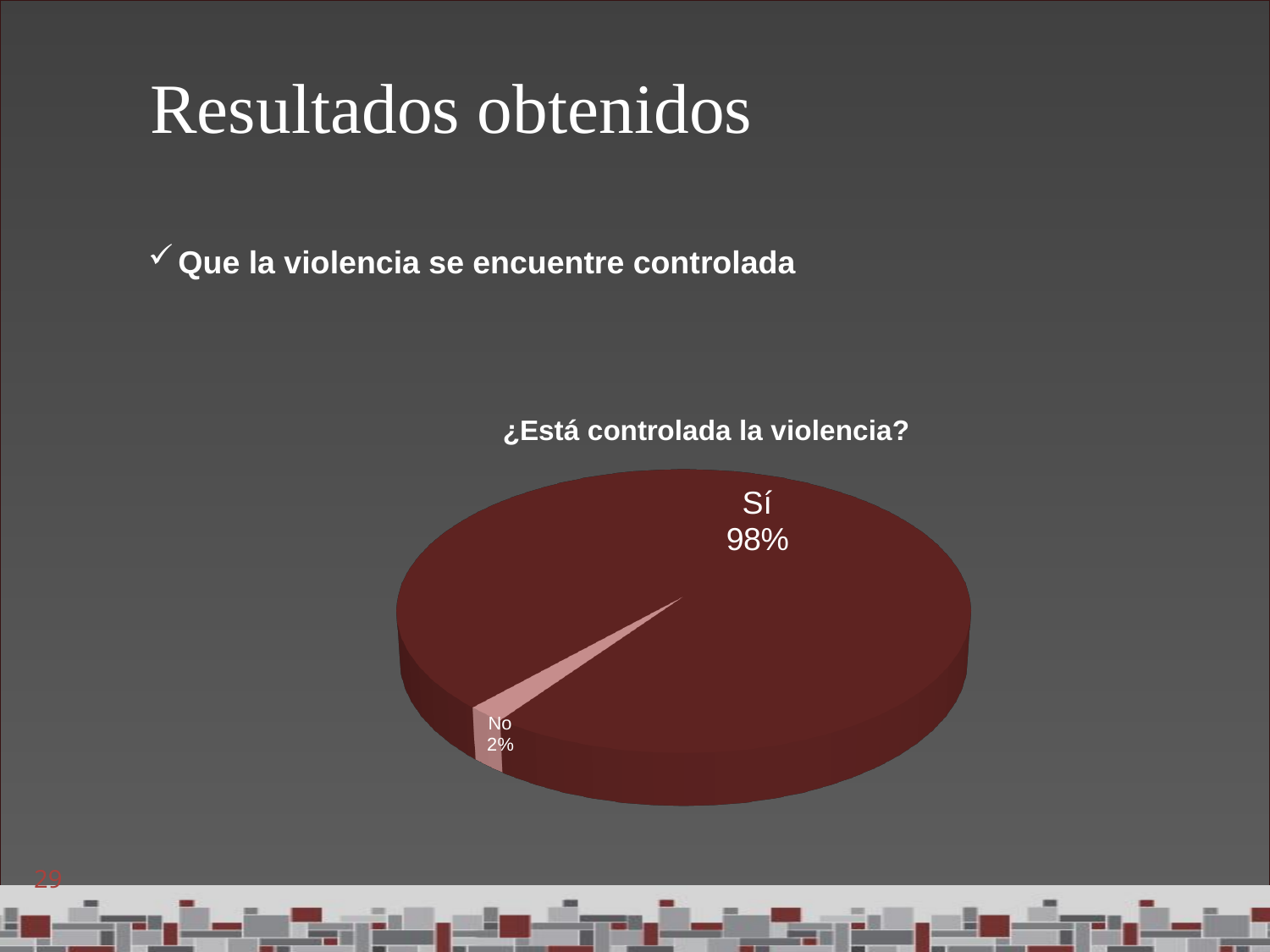
Which is larger, the "Sí" slice or the "No" slice? Sí Which slice is the largest in the pie chart? Sí What colour is the "Sí" slice? Dark red What type of chart is shown on the slide? Pie chart What is the difference in percentage points between the "Sí" and "No" slices? 96 How many slices does the pie chart have? 2 What is the title of the chart? ¿Está controlada la violencia? Which slice is the smallest in the pie chart? No What share of the pie does the "No" slice represent? 2% What percentage of the pie corresponds to "Sí"? 98% What percentage of the pie corresponds to "No"? 2%